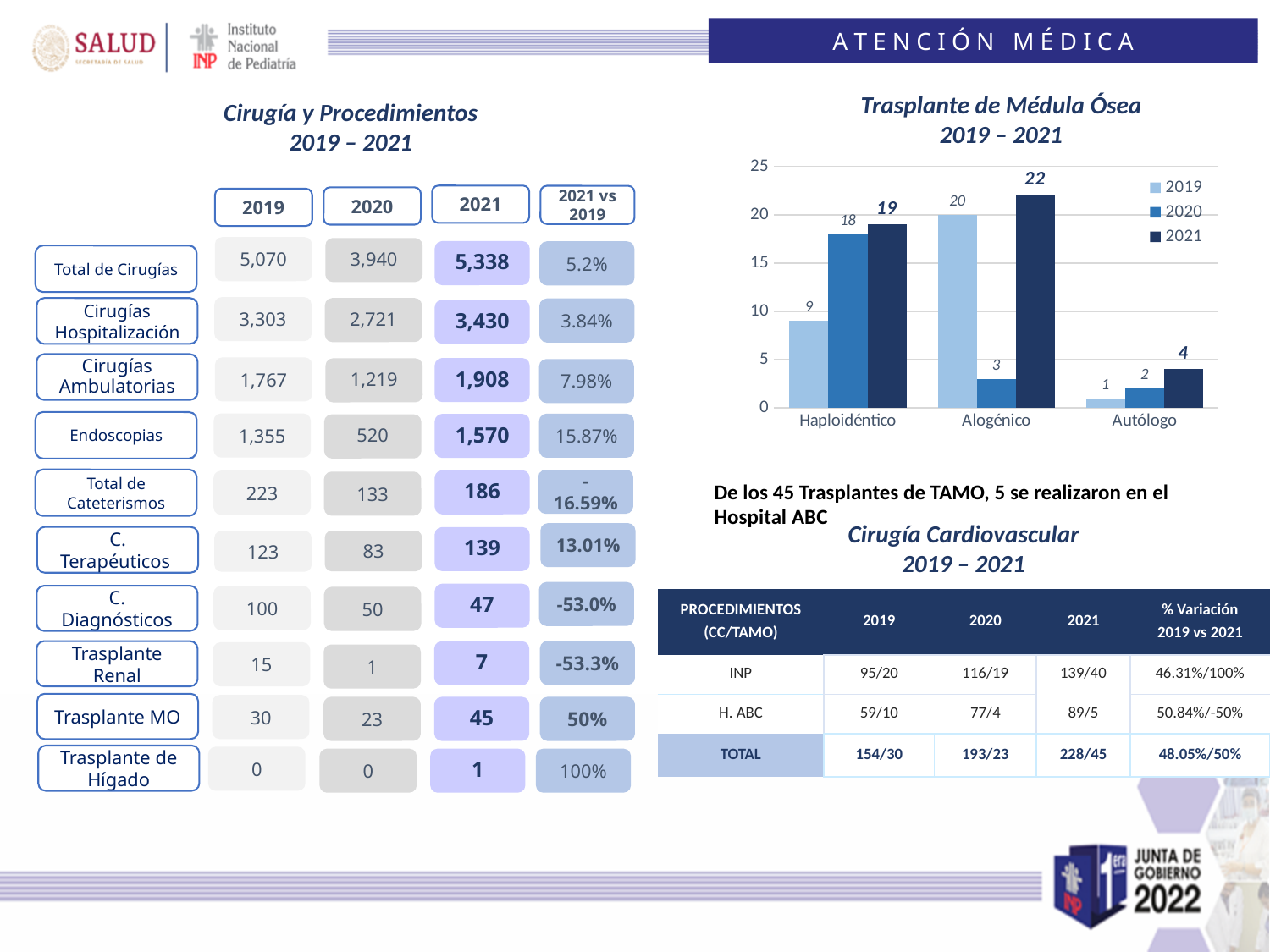
In the Trasplante de Médula Ósea chart, which category has the highest 2021 value? Alogénico In the Trasplante de Médula Ósea chart, do the values for Autólogo rise or fall from 2019 to 2021? Rise In the Trasplante de Médula Ósea chart, which is larger for Haploidéntico: the 2019 value or the 2020 value? 2020 In the Trasplante de Médula Ósea chart, which category has the lowest 2019 value? Autólogo In the Trasplante de Médula Ósea chart, what is the difference between the 2019 and 2020 values for Alogénico? 17 How many series does the legend of the Trasplante de Médula Ósea chart list? 3 In the Trasplante de Médula Ósea chart, what is the 2020 value for Autólogo? 2 What kind of chart is the Trasplante de Médula Ósea chart? Bar chart In the Trasplante de Médula Ósea chart, is the 2019 value for Alogénico greater or less than 15? greater How many categories are shown on the x axis of the Trasplante de Médula Ósea chart? 3 In the Trasplante de Médula Ósea chart, what is the 2019 value for Haploidéntico? 9 In the Trasplante de Médula Ósea chart, what is the 2021 value for Alogénico? 22